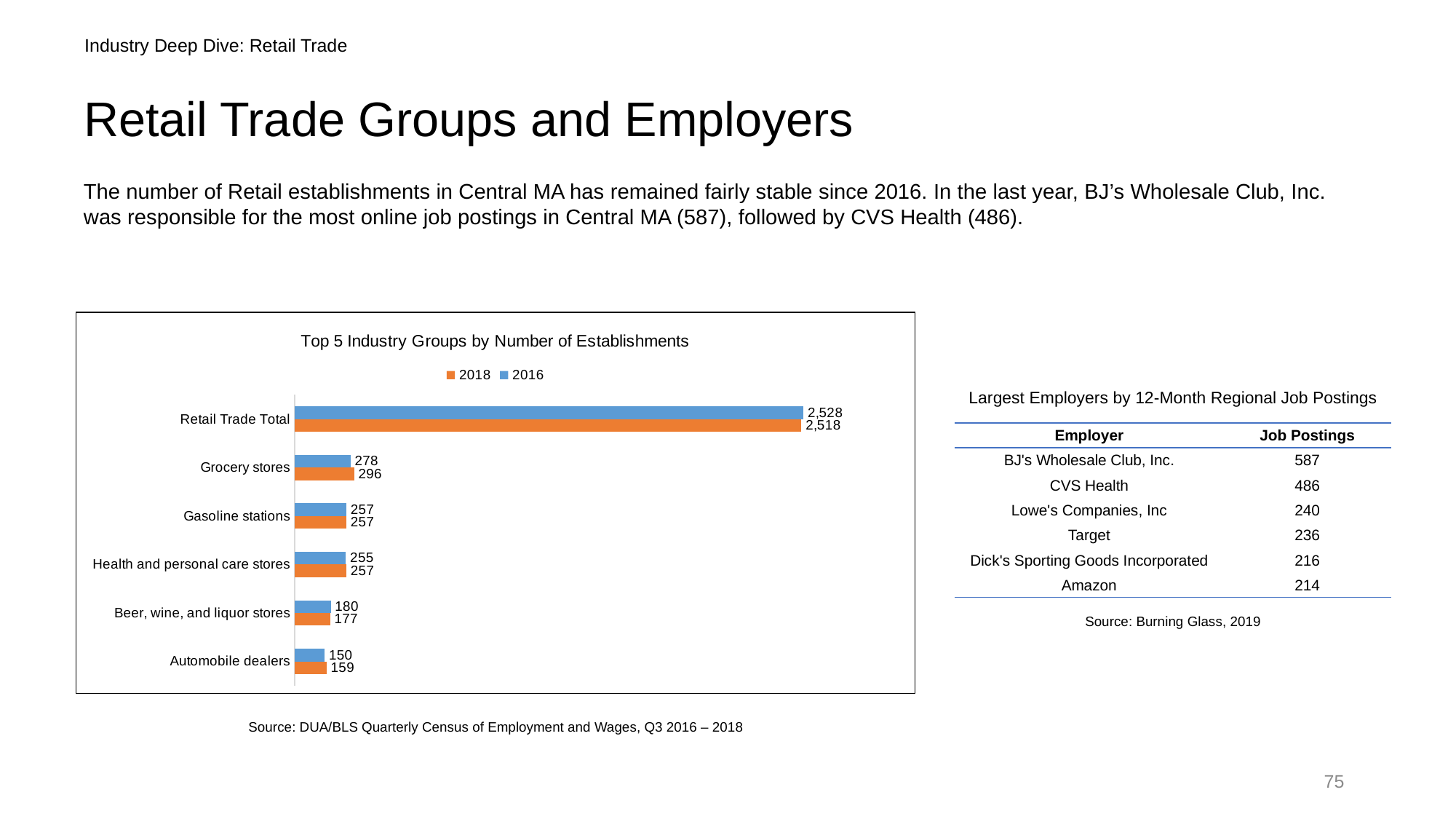
Excluding Retail Trade Total, which category has the highest 2018 value? Grocery stores What is the 2018 value for Grocery stores? 296 Excluding Retail Trade Total, which category has the lowest 2016 value? Automobile dealers What is the difference between the 2018 and 2016 values for Grocery stores? 18 How many series does the chart legend list? 2 What is the 2018 value for Automobile dealers? 159 Which is larger for Automobile dealers, the 2016 value or the 2018 value? 2018 How many categories are plotted in the chart? 6 What is the 2016 value for Beer, wine, and liquor stores? 180 What is the 2016 value for Retail Trade Total? 2,528 What is the title of the chart? Top 5 Industry Groups by Number of Establishments What kind of chart is shown on the slide? bar chart